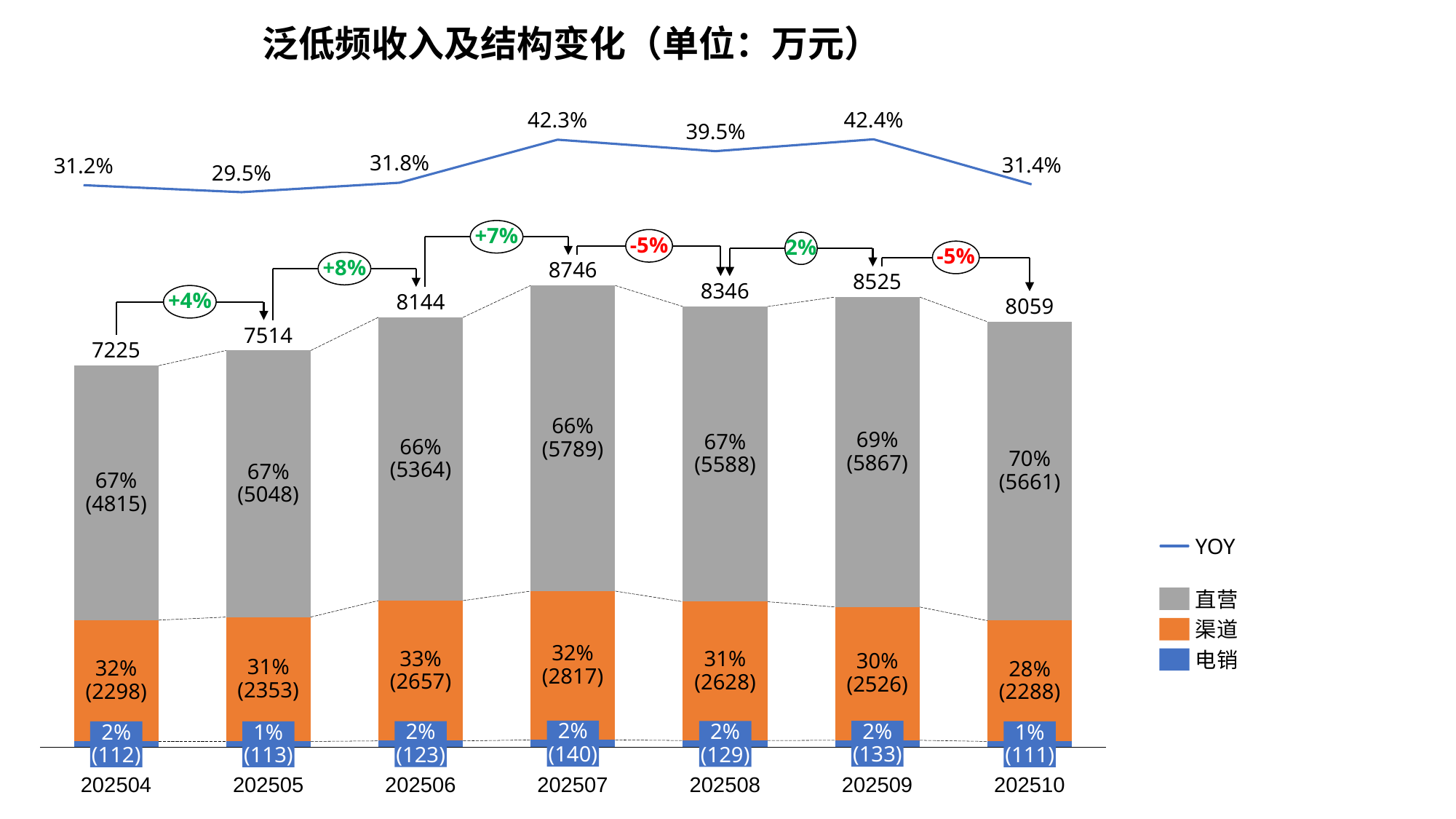
What kind of chart is this? Stacked bar chart with a line What percentage share does 渠道 have in 202510? 28% How many months are shown on the x axis? 7 Which month has the lowest total bar value? 202504 What is the YOY value shown for 202509? 42.4% Which is larger, the 渠道 value for 202506 or for 202508? 202506 What is the 直营 value (in parentheses) for 202507? 5789 Does the YOY line rise or fall from 202509 to 202510? Fall What is the difference between the total for 202507 and the total for 202508? 400 What is the total of the stacked bar for 202510? 8059 How many series does the legend list? 4 Which month has the highest total bar value? 202507